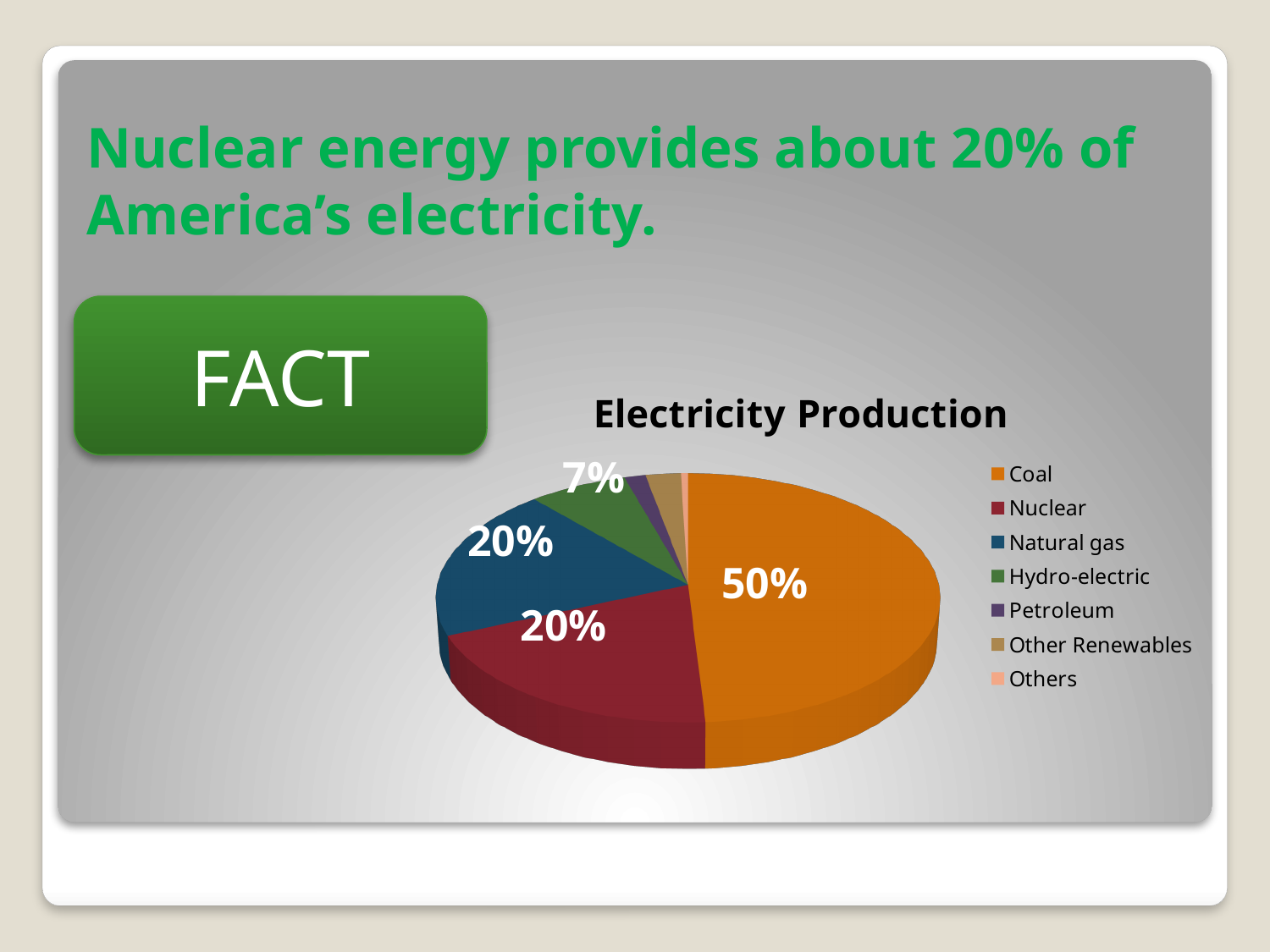
What kind of chart is shown on the slide? pie chart How many percentage points larger is the Coal share than the Nuclear share? 30 What percentage of electricity production does Nuclear account for? 20% Which category has the largest share of electricity production? Coal What percentage of electricity production does Natural gas account for? 20% Which is larger, the share for Coal or the share for Natural gas? Coal How many categories does the legend of the chart list? 7 What is the title of the chart? Electricity Production What percentage of electricity production does Coal account for? 50% What percentage of electricity production does Hydro-electric account for? 7% Which is larger, the share for Nuclear or the share for Hydro-electric? Nuclear How many percentage points larger is the Natural gas share than the Hydro-electric share? 13